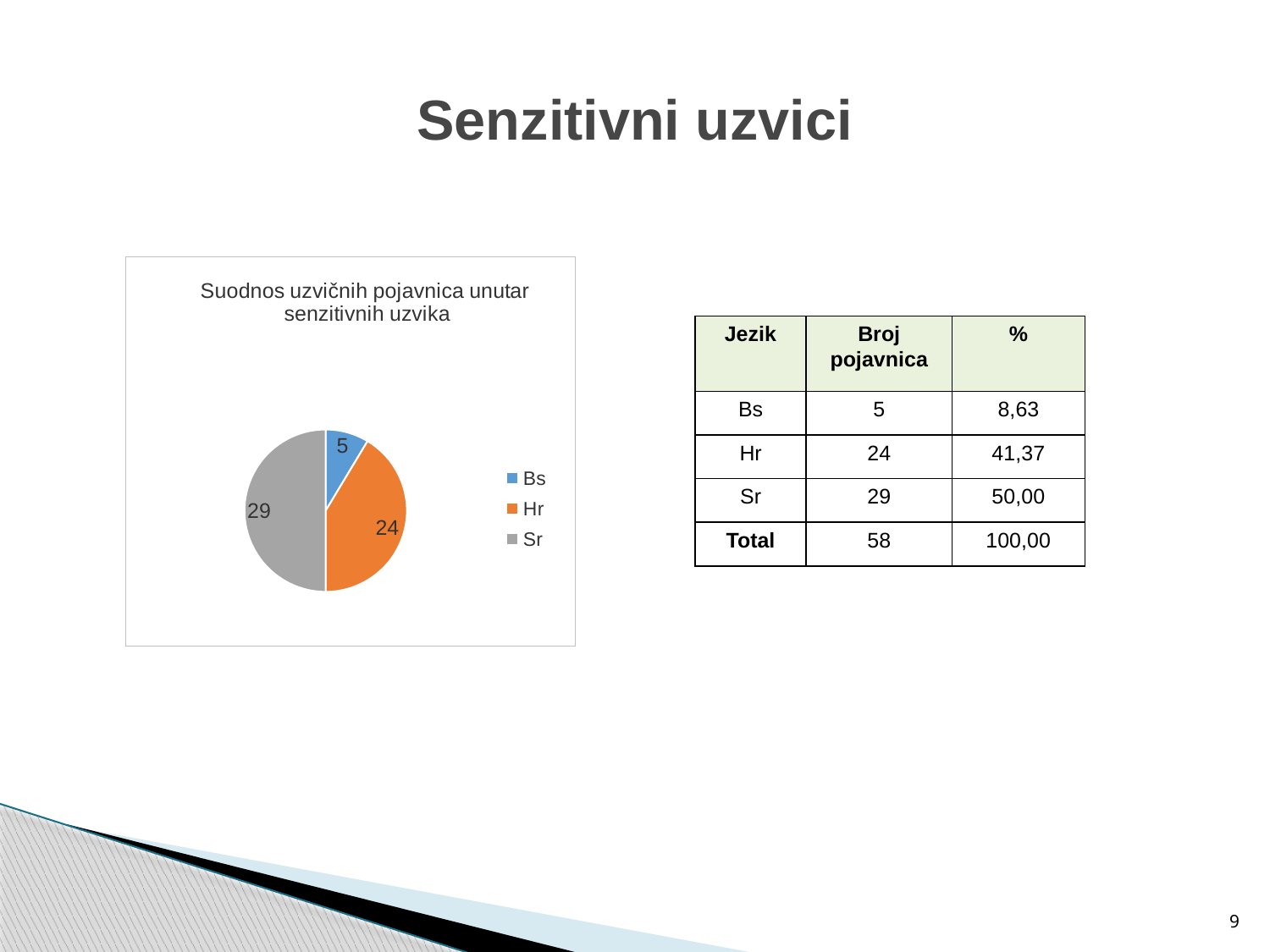
What is the value for Sr in the pie chart? 29 What is the total of all slices in the pie chart? 58 What is the difference between the values for Sr and Hr in the pie chart? 5 Which is larger in the pie chart, Hr or Bs? Hr What is the value for Hr in the pie chart? 24 What type of chart is shown on the slide? pie chart Which category has the smallest slice in the pie chart? Bs What is the difference between the values for Hr and Bs in the pie chart? 19 What is the title of the pie chart? Suodnos uzvičnih pojavnica unutar senzitivnih uzvika How many categories does the pie chart show? 3 Which category has the largest slice in the pie chart? Sr What is the value for Bs in the pie chart? 5